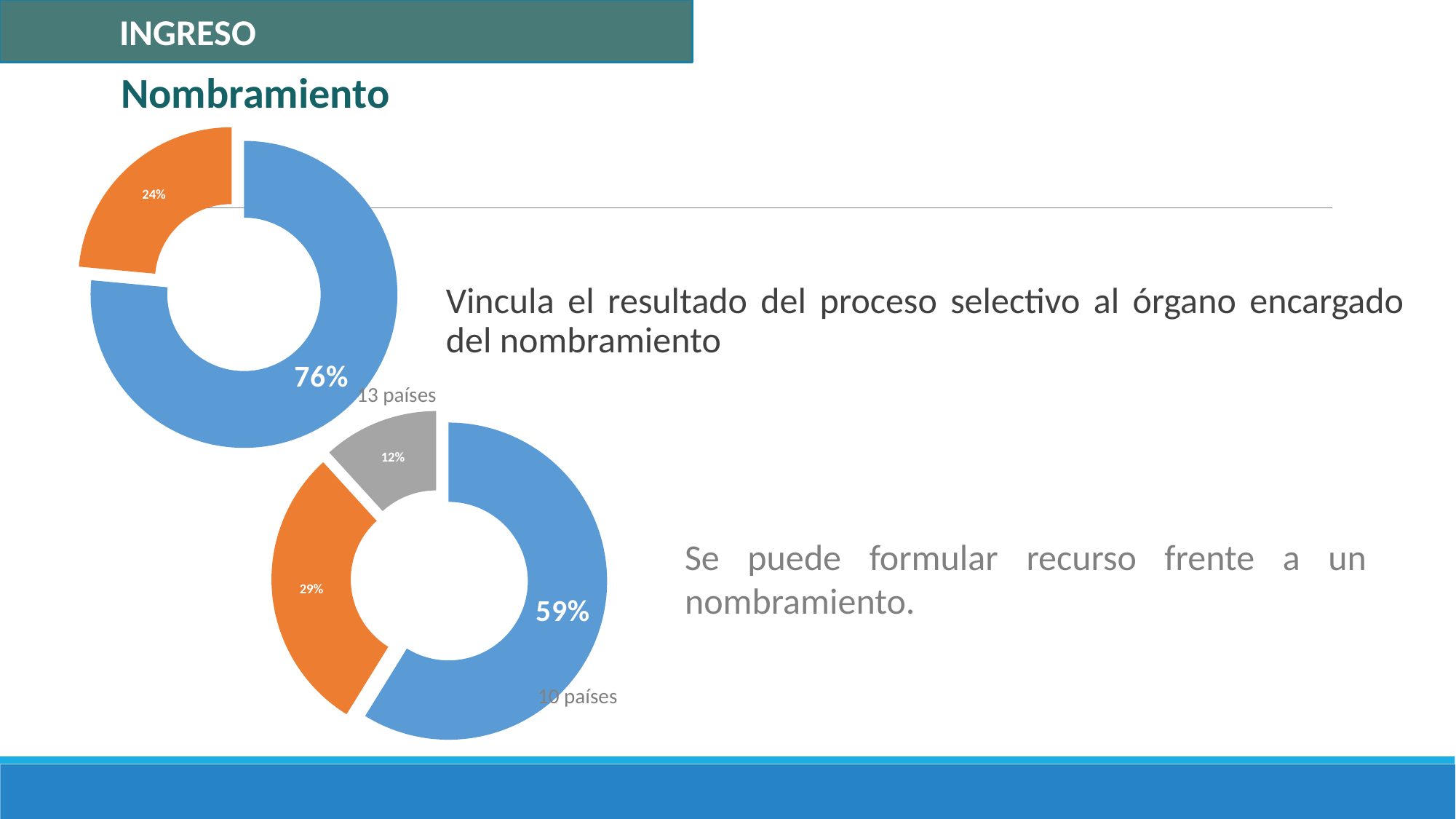
What number of countries is noted next to the lower chart? 10 países In the upper-left chart, what is the difference between the blue slice and the orange slice? 52% In the upper-left chart, what percentage does the blue slice show? 76% In the lower chart, what percentage does the blue slice show? 59% In the lower chart, what percentage does the grey slice show? 12% How many slices does the lower chart have? 3 What kind of chart is the upper-left chart on the slide? doughnut chart How many slices does the upper-left chart have? 2 In the lower chart, which is larger, the orange slice or the grey slice? the orange slice In the lower chart, what percentage does the orange slice show? 29% In the lower chart, which slice is the smallest? the grey slice (12%) In the upper-left chart, what percentage does the orange slice show? 24%